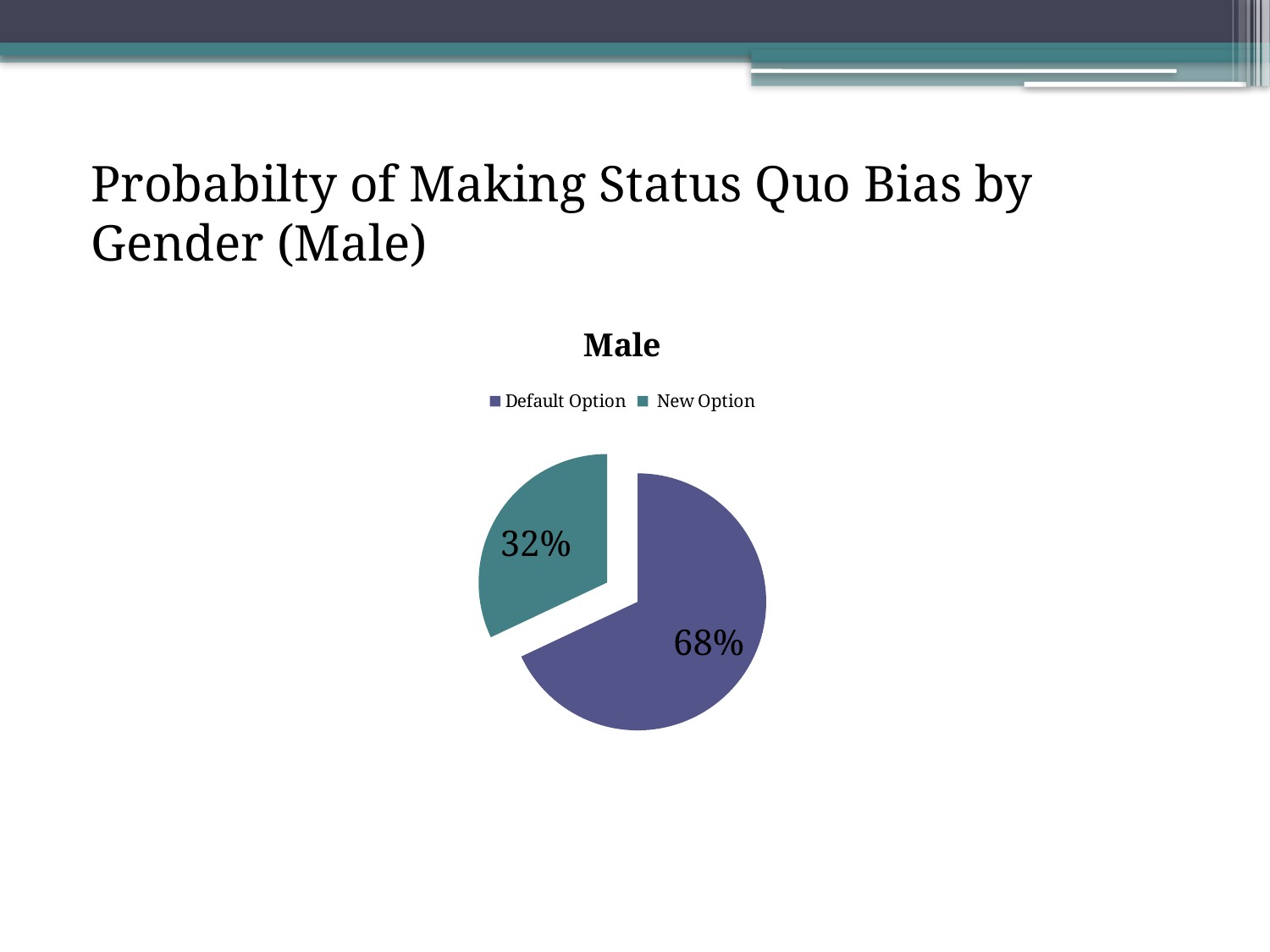
How many entries does the legend list? 2 Which legend entry is shown in teal? New Option What share of the pie does Default Option take? 68% How many slices does the pie chart have? 2 What kind of chart is shown on the slide? Pie chart Which slice is the smallest? New Option What is the difference in percentage points between Default Option and New Option? 36 What share of the pie does New Option take? 32% What is the title of the chart? Male Which slice is the largest? Default Option Which is larger, Default Option or New Option? Default Option